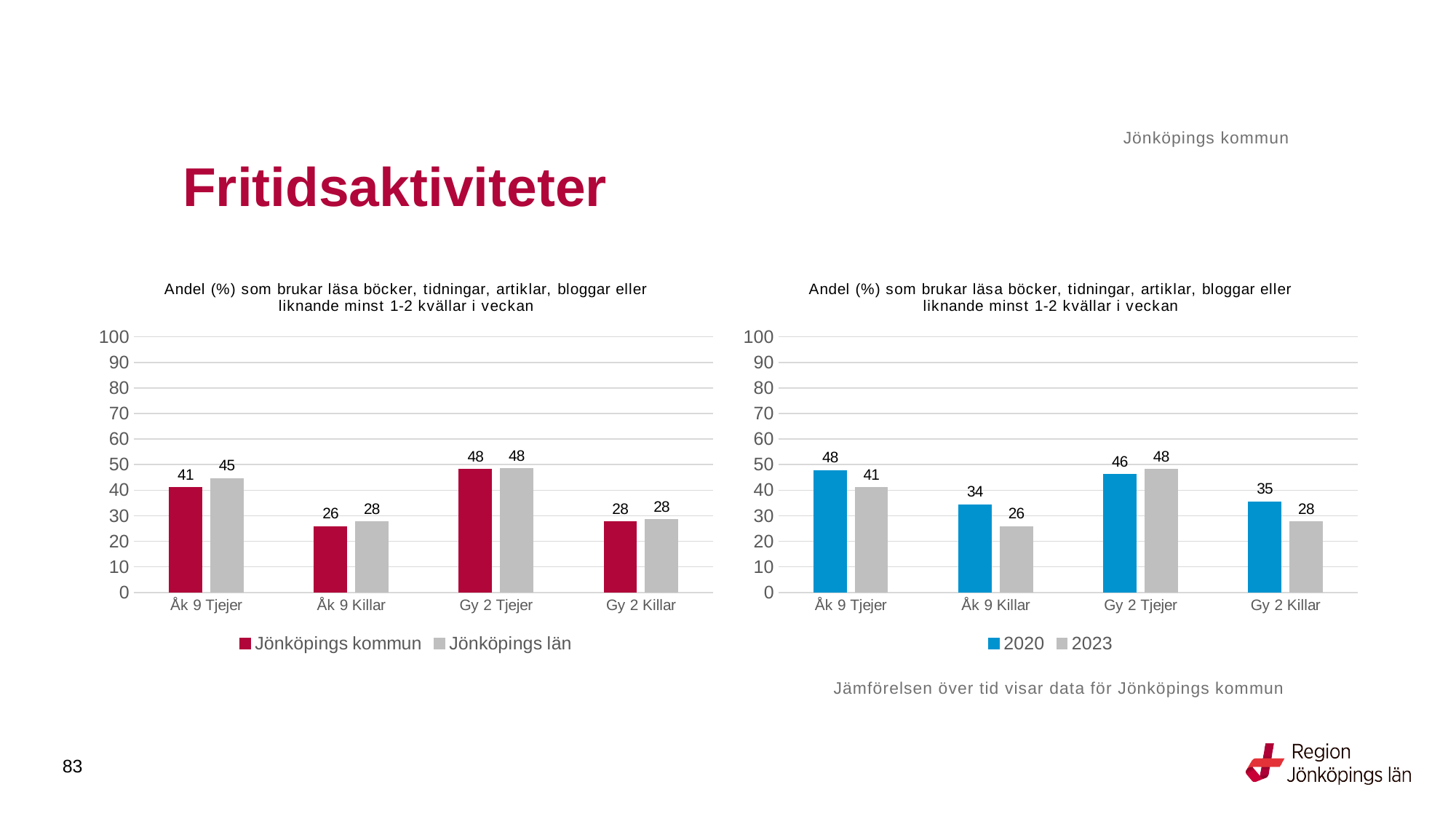
What type of chart is the left chart? bar chart In the right chart, what is the 2020 value for Gy 2 Killar? 35 In the right chart, what is the difference between the 2020 and 2023 values for Åk 9 Killar? 8 In the right chart, what is the 2023 value for Åk 9 Killar? 26 How many categories are shown on the x axis of the left chart? 4 In the left chart, what is the difference between Jönköpings län and Jönköpings kommun for Åk 9 Tjejer? 4 In the right chart, is the 2020 value for Gy 2 Tjejer larger or smaller than the 2023 value? smaller In the left chart, what is the value for Jönköpings län for Åk 9 Killar? 28 How many series does the legend of the right chart list? 2 In the left chart, what is the value for Jönköpings kommun for Åk 9 Tjejer? 41 In the right chart, which category has the highest 2020 value? Åk 9 Tjejer In the left chart, which category has the lowest value for Jönköpings kommun? Åk 9 Killar